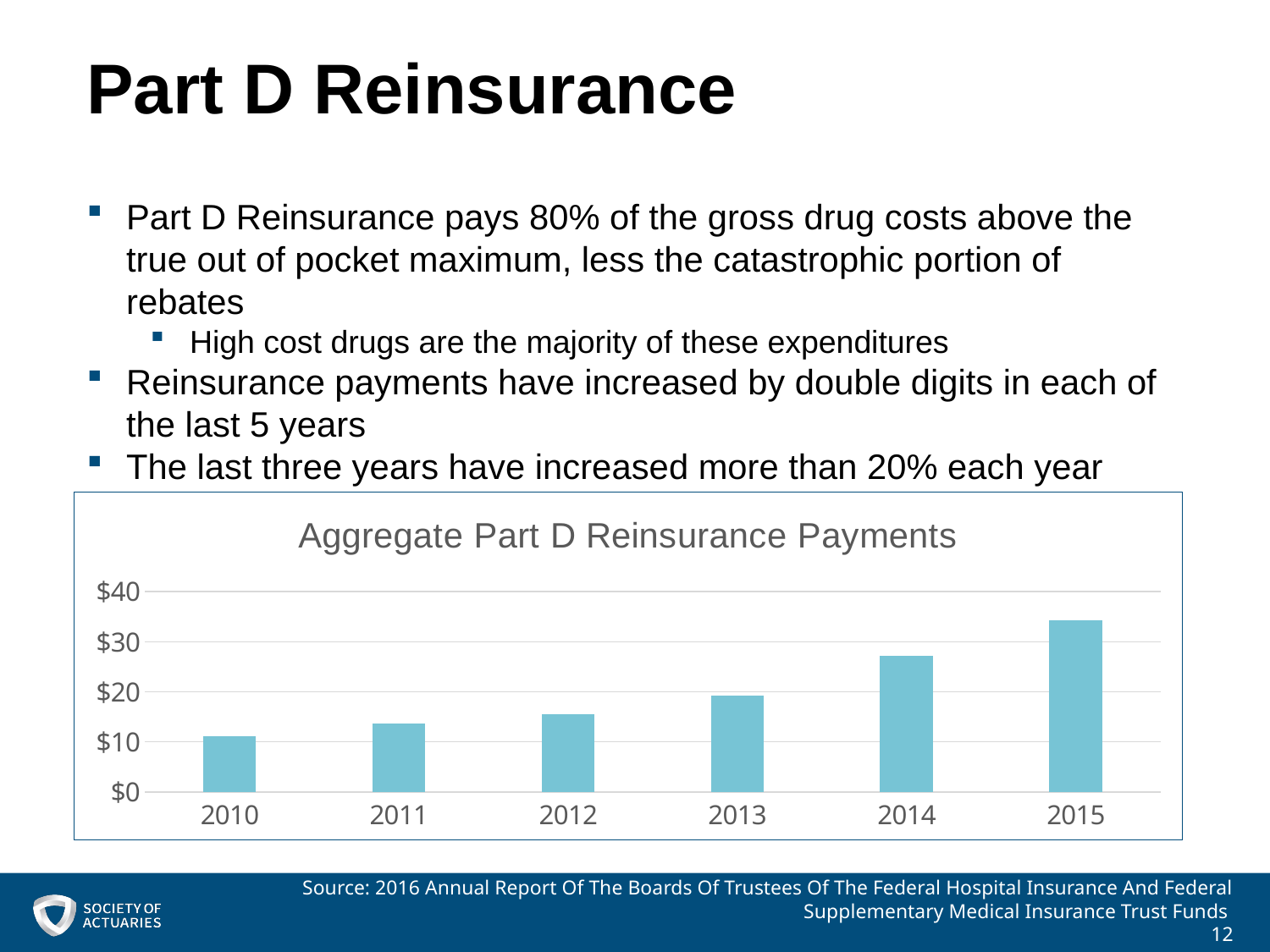
How many years are shown on the x axis of the chart? 6 Is the value for 2015 greater or less than $40? less Do the aggregate Part D reinsurance payments rise or fall from 2010 to 2015? rise Is the value for 2011 greater or less than $10? greater Which year has the highest aggregate Part D reinsurance payments? 2015 Is the value for 2012 greater or less than $20? less What type of chart is shown on the slide? bar chart Which year has larger aggregate Part D reinsurance payments, 2012 or 2014? 2014 What is the title of the chart? Aggregate Part D Reinsurance Payments Which year has the lowest aggregate Part D reinsurance payments? 2010